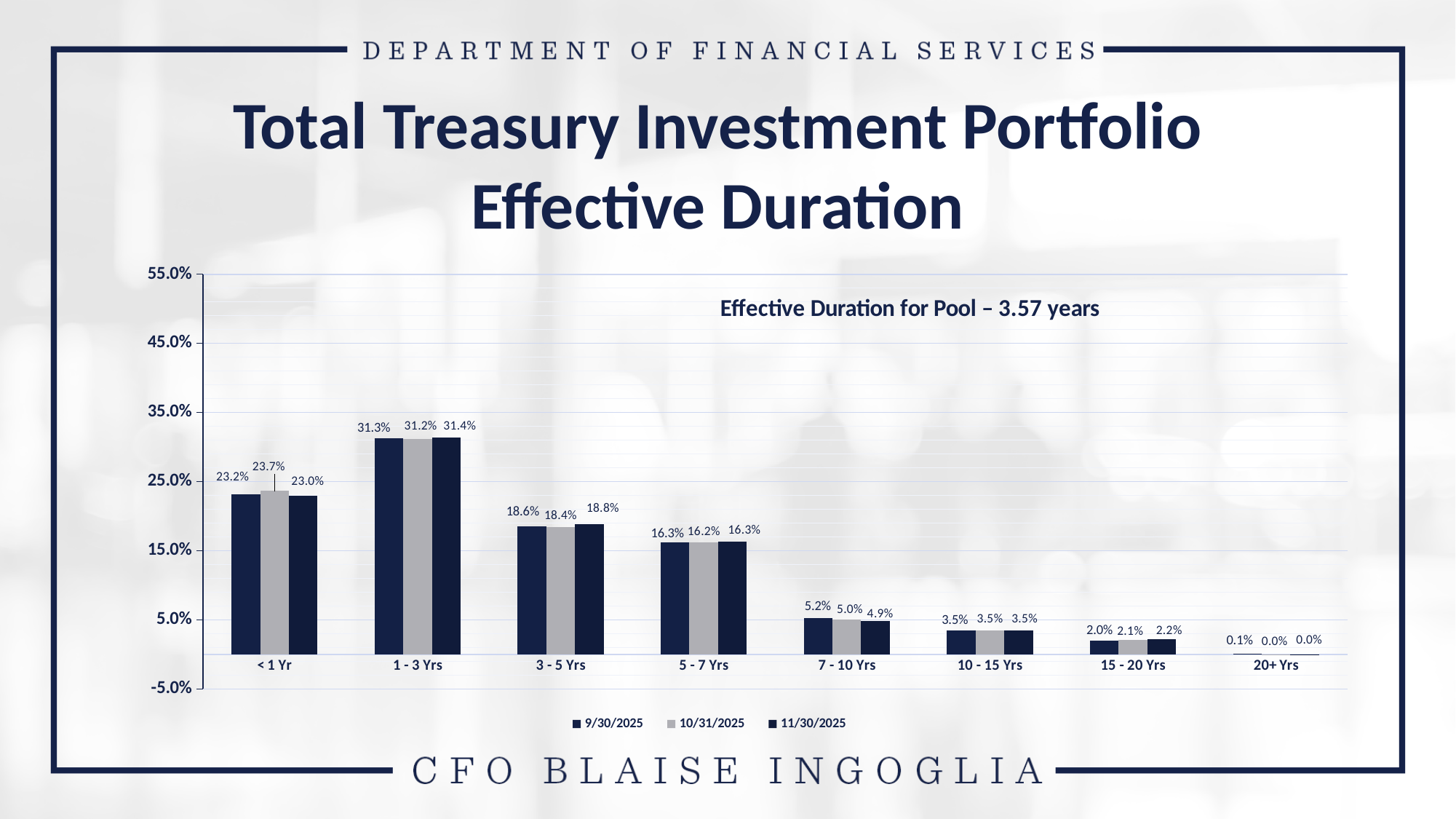
Which category has the lowest value in the 11/30/2025 series? 20+ Yrs What effective duration for the pool is stated on the chart? 3.57 years Which category has the highest value in the 9/30/2025 series? 1 - 3 Yrs What is the value for the 7 - 10 Yrs category in the 9/30/2025 series? 5.2% What is the value for the < 1 Yr category in the 10/31/2025 series? 23.7% In the 10/31/2025 series, which is larger: the value for < 1 Yr or the value for 3 - 5 Yrs? < 1 Yr What is the difference between the 1 - 3 Yrs and 3 - 5 Yrs values in the 11/30/2025 series? 12.6% How many series does the legend list? 3 How many categories are shown on the x axis? 8 From the 1 - 3 Yrs category onward, do the values in the 9/30/2025 series rise or fall along the x axis? Fall What is the value for the 1 - 3 Yrs category in the 11/30/2025 series? 31.4% What kind of chart is shown on the slide? Bar chart